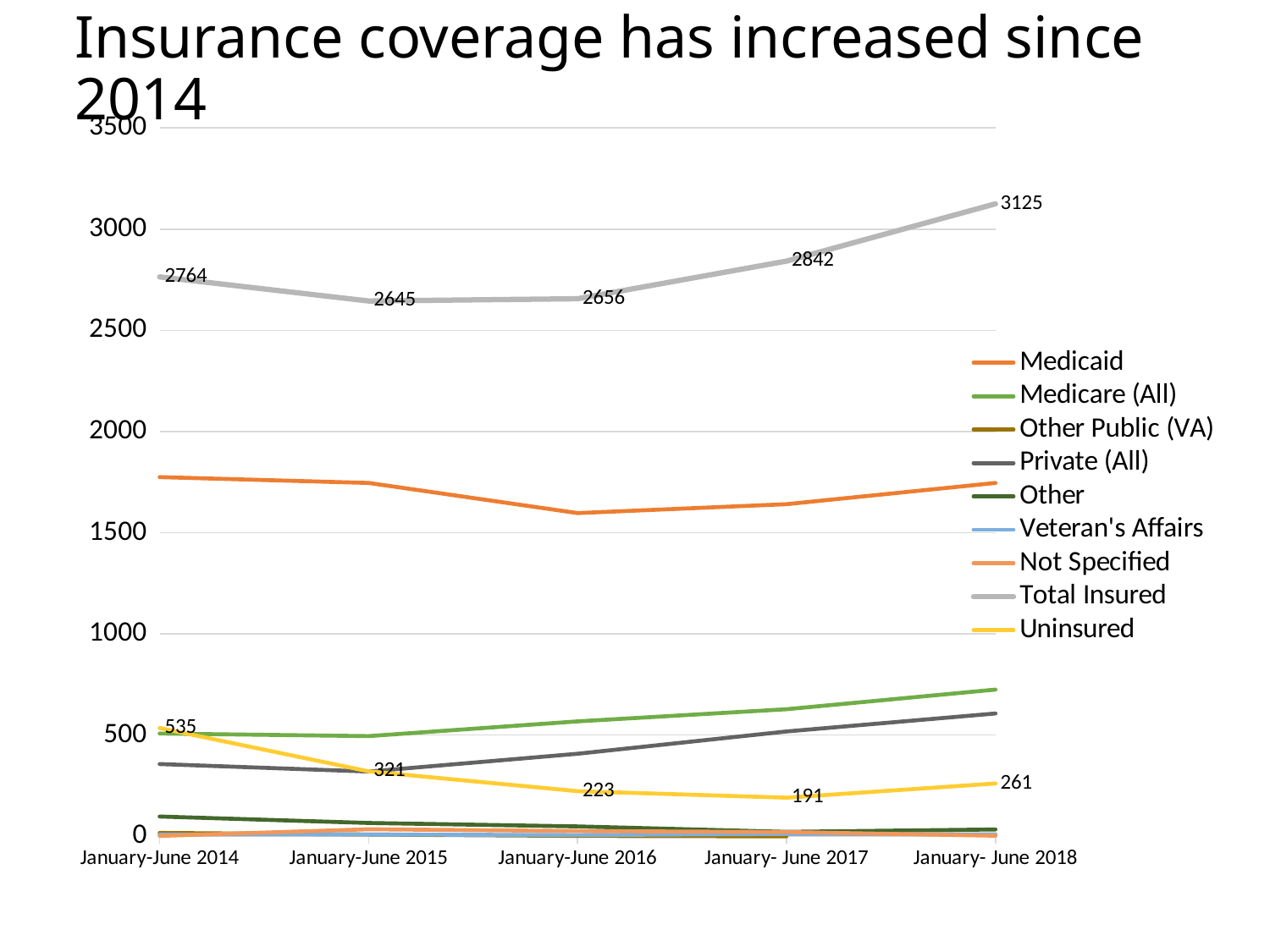
What is the value of Total Insured for January-June 2014? 2764 In which period is Uninsured lowest? January- June 2017 What is the value of Uninsured for January- June 2017? 191 What is the value of Total Insured for January- June 2018? 3125 What is the difference between Total Insured in January- June 2018 and January-June 2014? 361 How many series does the legend list? 9 How many time periods are shown on the x axis? 5 Which is larger, Total Insured in January-June 2015 or in January-June 2016? January-June 2016 In which period is Total Insured highest? January- June 2018 Is the value for Medicaid in January-June 2014 greater or less than 1500? greater What is the difference between Uninsured in January-June 2014 and January-June 2015? 214 What kind of chart is shown on the slide? line chart